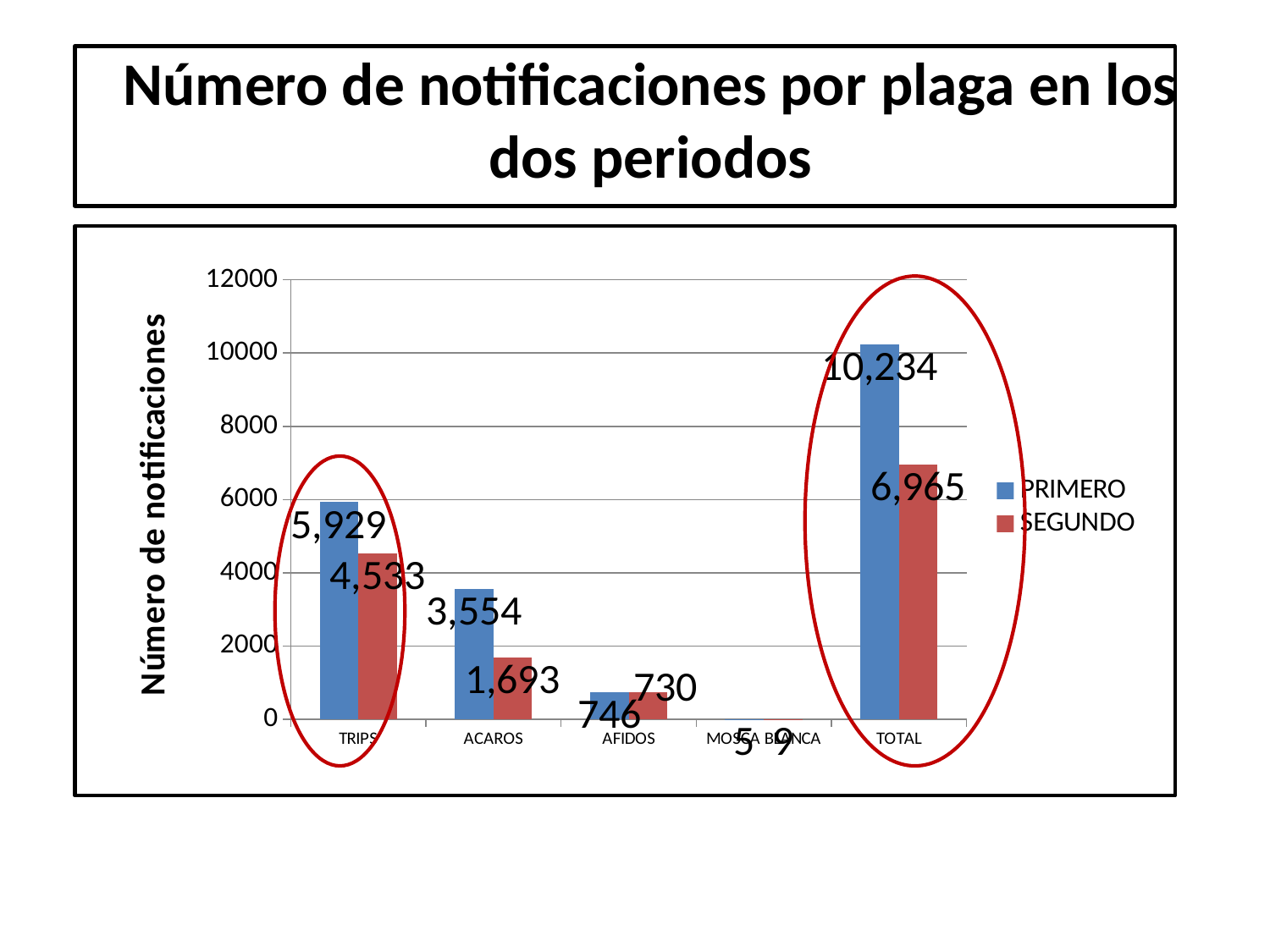
How many series does the legend list? 2 What is the SEGUNDO value for ACAROS? 1,693 What is the PRIMERO value for TOTAL? 10,234 Which is larger for ACAROS, the PRIMERO value or the SEGUNDO value? PRIMERO What is the difference between the PRIMERO and SEGUNDO values for TOTAL? 3,269 Which category has the highest PRIMERO value? TOTAL What is the SEGUNDO value for AFIDOS? 730 How many categories are shown on the x axis? 5 What is the PRIMERO value for TRIPS? 5,929 What is the label of the y axis? Número de notificaciones What type of chart is shown on the slide? bar chart Which category has the lowest SEGUNDO value? MOSCA BLANCA